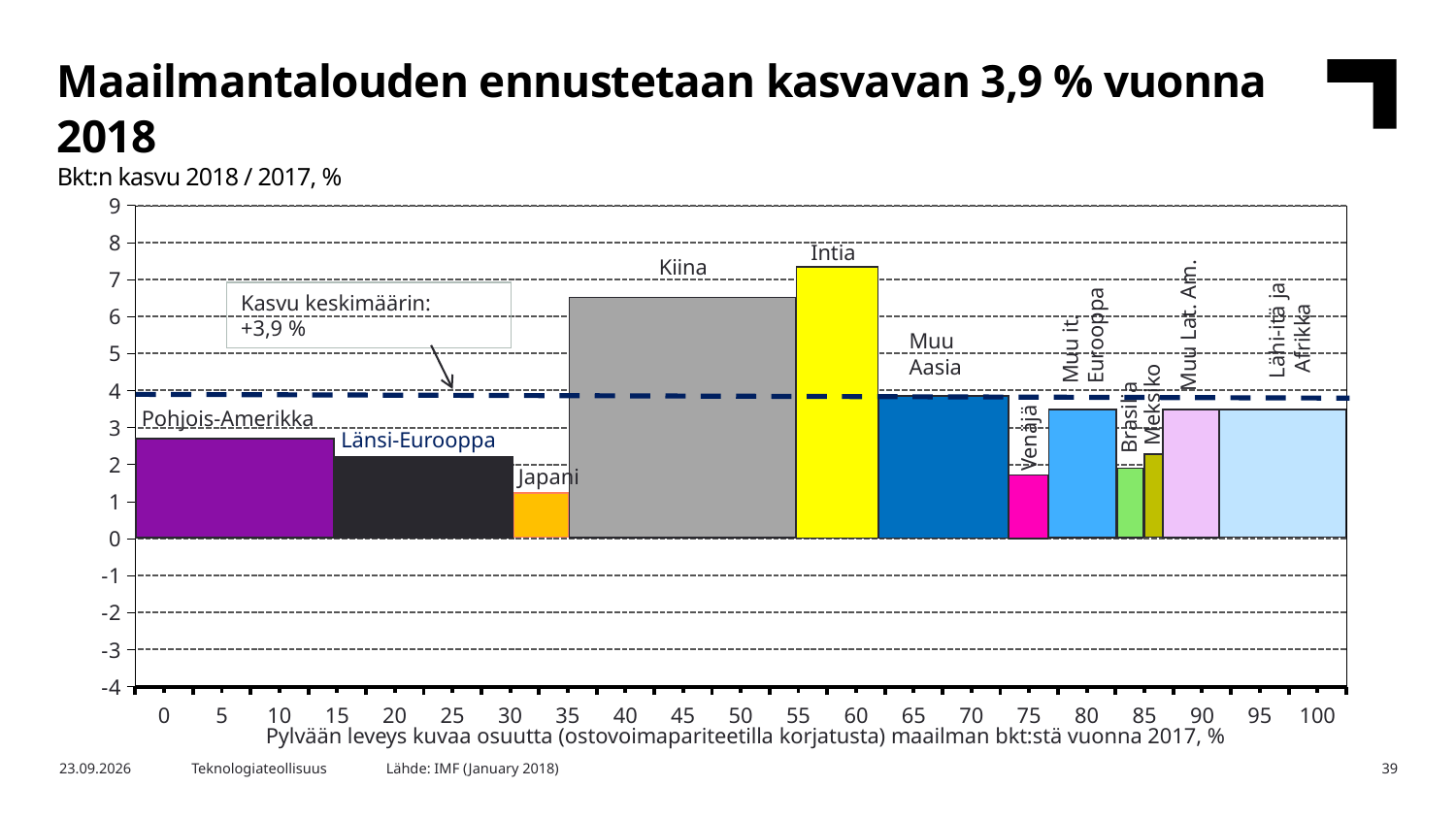
According to the chart's subtitle, what does the chart measure? Bkt:n kasvu 2018 / 2017, % Is the value for Japani greater or less than 2? less Is the value for Pohjois-Amerikka greater or less than 3? less Which region has the highest GDP growth forecast in the chart? Intia Is the value for Kiina greater or less than 6? greater How many regions are shown as bars in the chart? 12 Which region has the lowest GDP growth forecast in the chart? Japani What is the average growth (Kasvu keskimäärin) shown in the chart's annotation? +3,9 % What kind of chart is shown on the slide? bar chart Which has the higher growth forecast, Kiina or Intia? Intia Which has the higher growth forecast, Pohjois-Amerikka or Länsi-Eurooppa? Pohjois-Amerikka